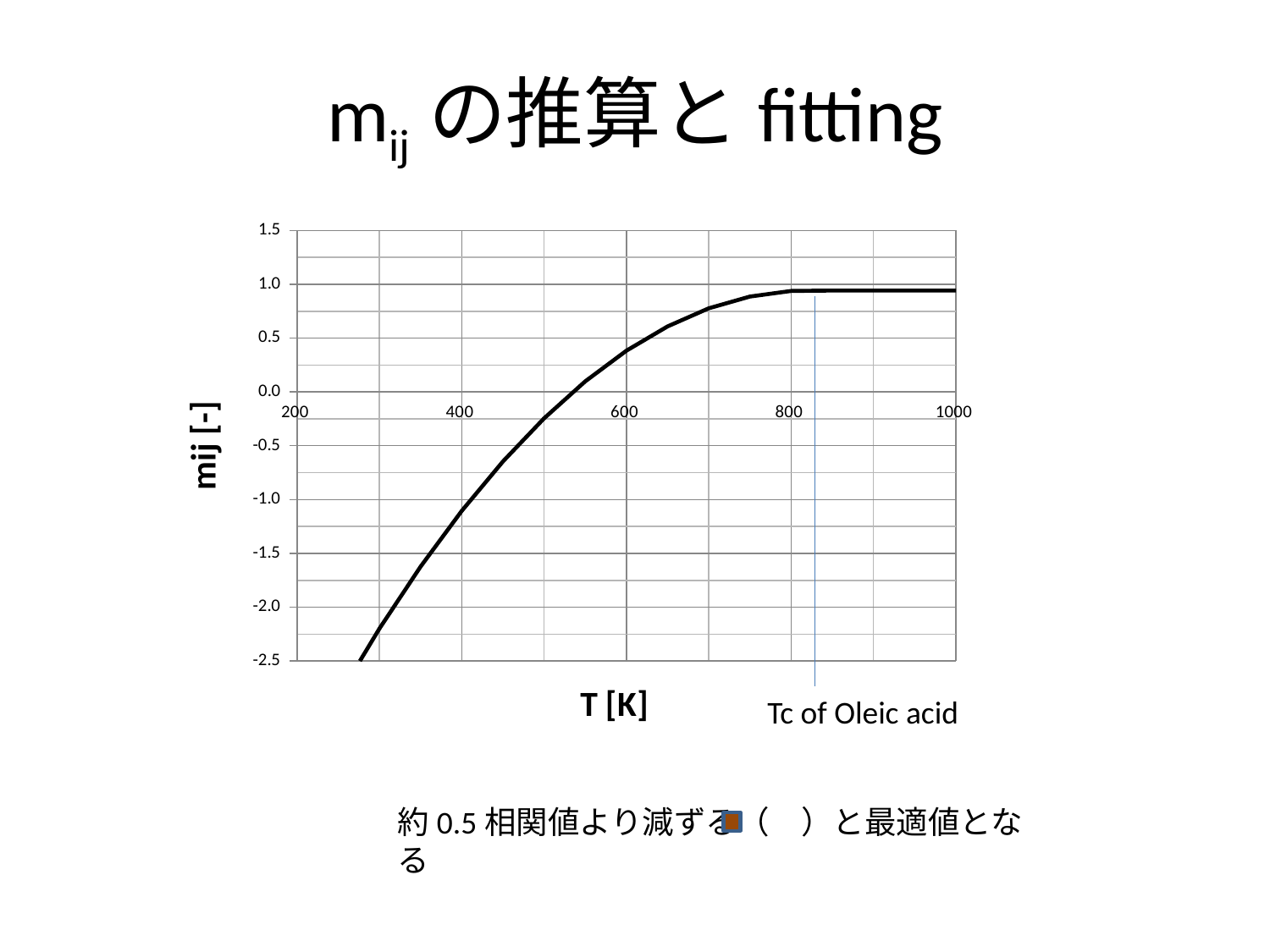
What is the label of the x axis? T [K] What is the label of the y axis? mij [-] Is the value of mij at T = 500 K greater or less than 0.0? less What is the lowest tick value shown on the y axis? -2.5 Is the value of mij at T = 600 K greater or less than 0.0? greater Is the value of mij at T = 800 K greater or less than 0.5? greater What kind of chart is shown on the slide? line chart Does the value of mij rise or fall as T increases from 200 K to 800 K? rise How many lines (data series) are plotted on the chart? 1